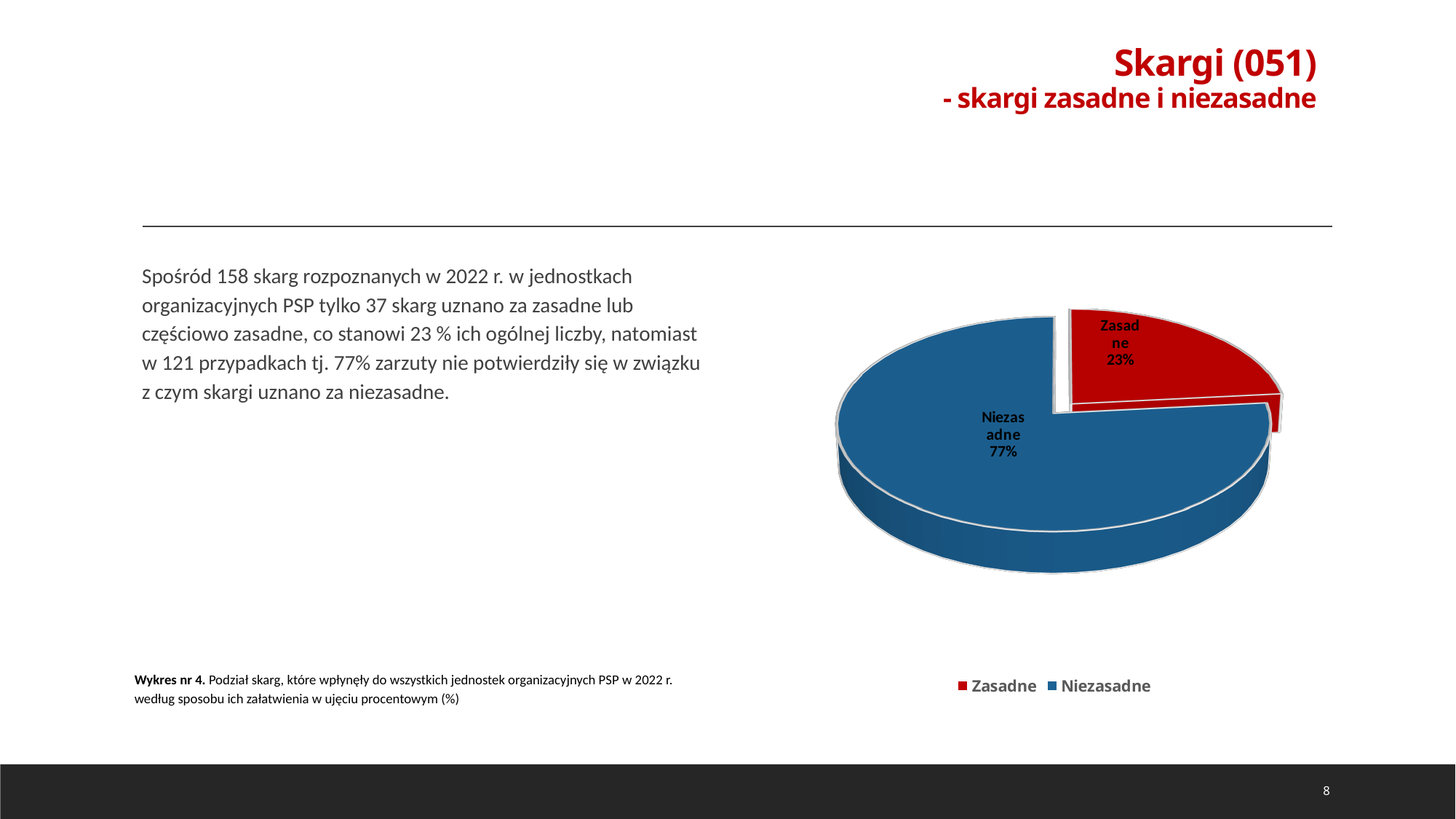
What colour is the Niezasadne slice in the pie chart? Blue What kind of chart is shown on the slide? Pie chart What share of the pie does the Zasadne slice represent? 23% What colour is the Zasadne slice in the pie chart? Red How many slices does the pie chart have? 2 Which slice is larger, Zasadne or Niezasadne? Niezasadne What is the difference in percentage points between the Niezasadne and Zasadne slices? 54 What percentage of the pie chart is labelled Zasadne? 23% Which slice of the pie chart is the smallest? Zasadne What percentage of the pie chart is labelled Niezasadne? 77% How many entries does the chart legend list? 2 Which slice of the pie chart is the largest? Niezasadne